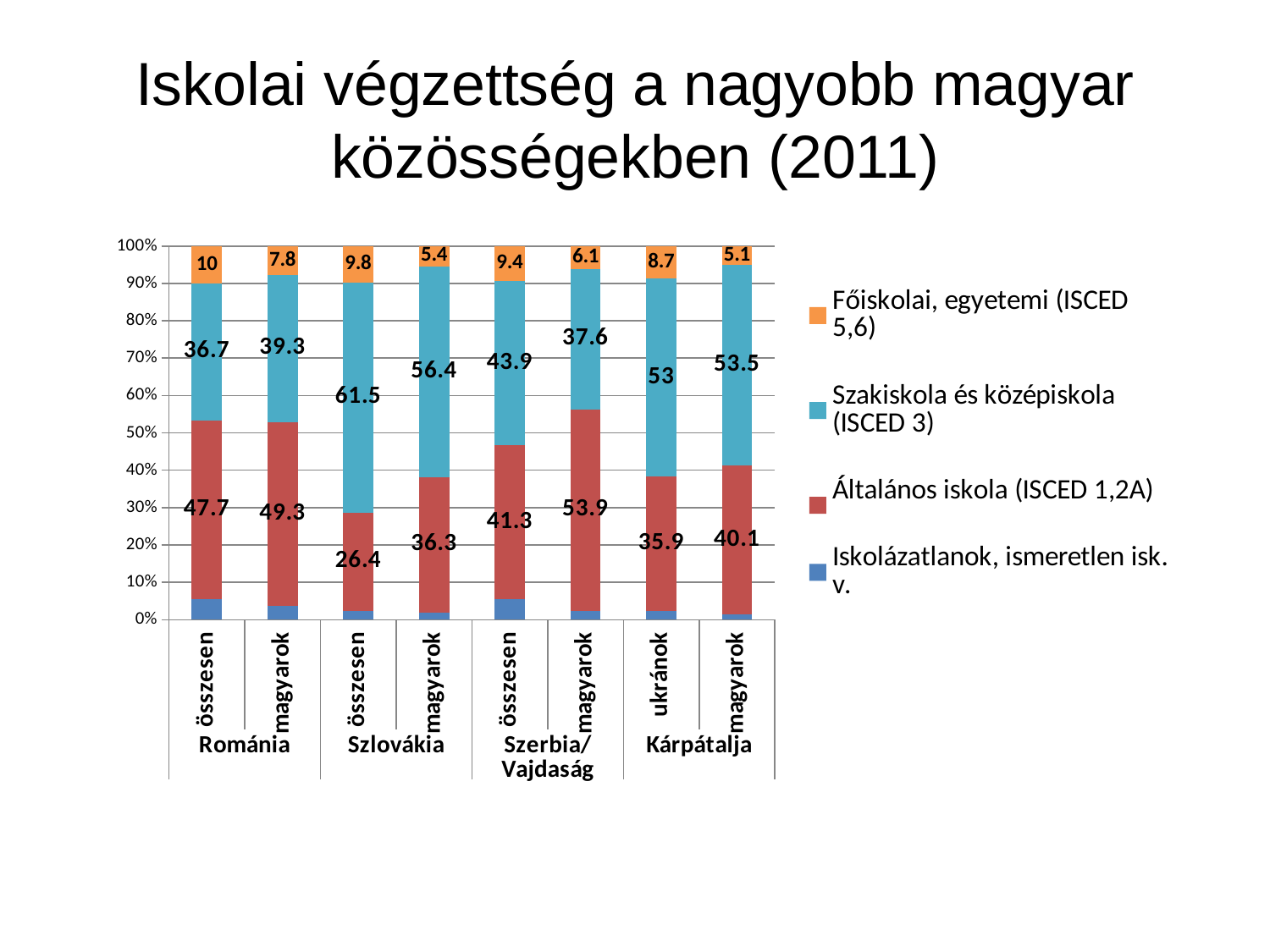
What is the value of Általános iskola (ISCED 1,2A) for Kárpátalja ukránok? 35.9 Which bar has the highest value for Szakiskola és középiskola (ISCED 3)? Szlovákia összesen What is the value of Főiskolai, egyetemi (ISCED 5,6) for Románia összesen? 10 What type of chart is shown on the slide? stacked bar chart Which bar has the lowest value for Főiskolai, egyetemi (ISCED 5,6)? Kárpátalja magyarok Which is larger: the Általános iskola (ISCED 1,2A) value for Szerbia/Vajdaság magyarok or for Szerbia/Vajdaság összesen? Szerbia/Vajdaság magyarok What is the value of Szakiskola és középiskola (ISCED 3) for Szlovákia magyarok? 56.4 Is the Iskolázatlanok, ismeretlen isk. v. share for Románia összesen greater or less than 10%? less What is the difference between the Szakiskola és középiskola (ISCED 3) values for Szlovákia összesen and Szlovákia magyarok? 5.1 How many series does the legend list? 4 Which bar has the lowest value for Általános iskola (ISCED 1,2A)? Szlovákia összesen How many bars are plotted in the chart? 8